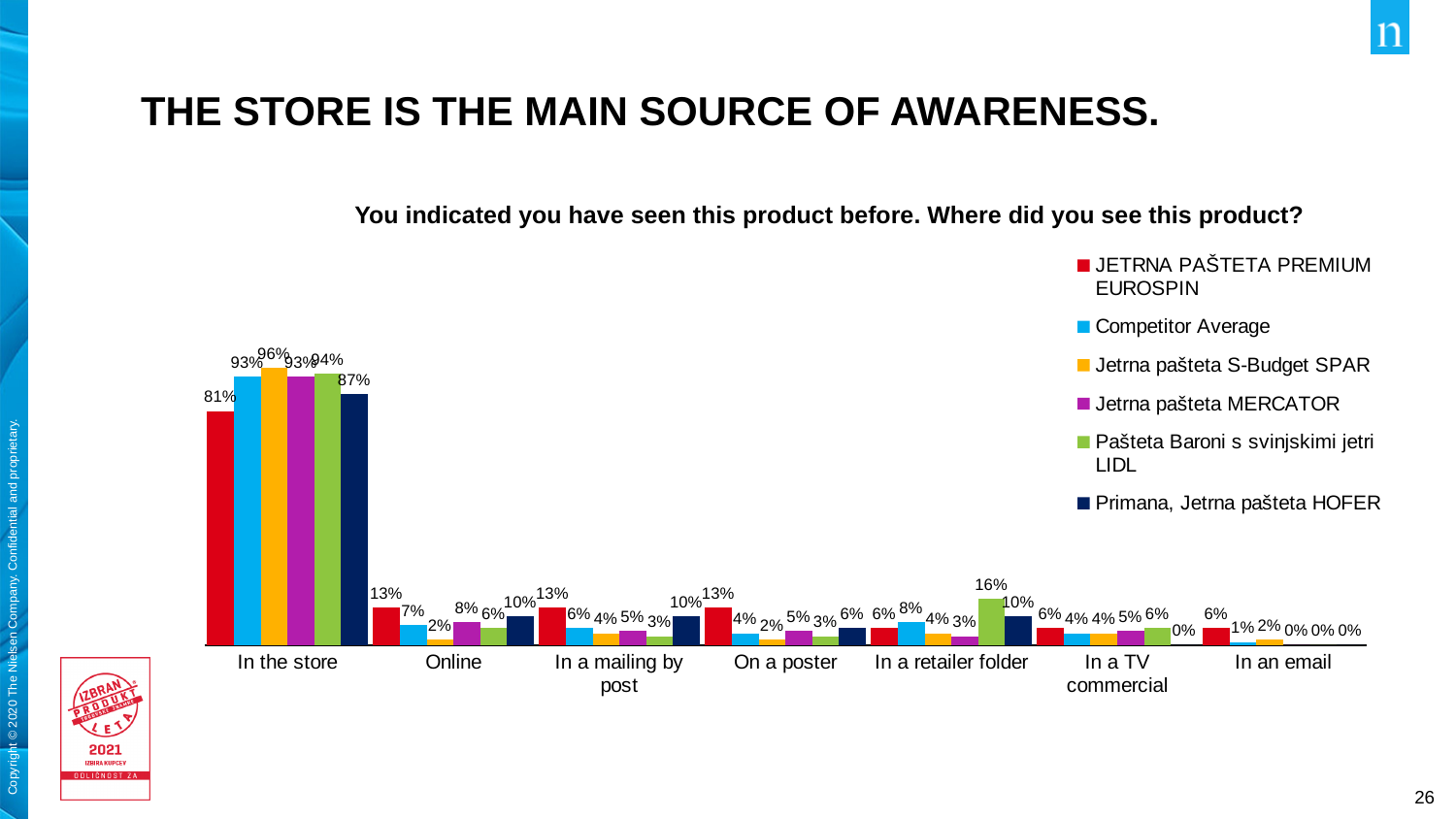
Which series has the highest value in the 'In the store' category? Jetrna pašteta S-Budget SPAR What is the value for Jetrna pašteta S-Budget SPAR in the 'In the store' category? 96% How many series does the legend list? 6 What is the value for JETRNA PAŠTETA PREMIUM EUROSPIN in the 'In the store' category? 81% Which series has the lowest value in the 'In the store' category? JETRNA PAŠTETA PREMIUM EUROSPIN What is the title of the chart? You indicated you have seen this product before. Where did you see this product? In the 'Online' category, which is larger: the value for JETRNA PAŠTETA PREMIUM EUROSPIN or for Competitor Average? JETRNA PAŠTETA PREMIUM EUROSPIN What is the difference between the Jetrna pašteta S-Budget SPAR and JETRNA PAŠTETA PREMIUM EUROSPIN values in the 'In the store' category? 15% What is the value for Pašteta Baroni s svinjskimi jetri LIDL in the 'In a retailer folder' category? 16% What kind of chart is shown on the slide? bar chart What is the value for Primana, Jetrna pašteta HOFER in the 'In a TV commercial' category? 0% How many categories are shown on the x axis? 7